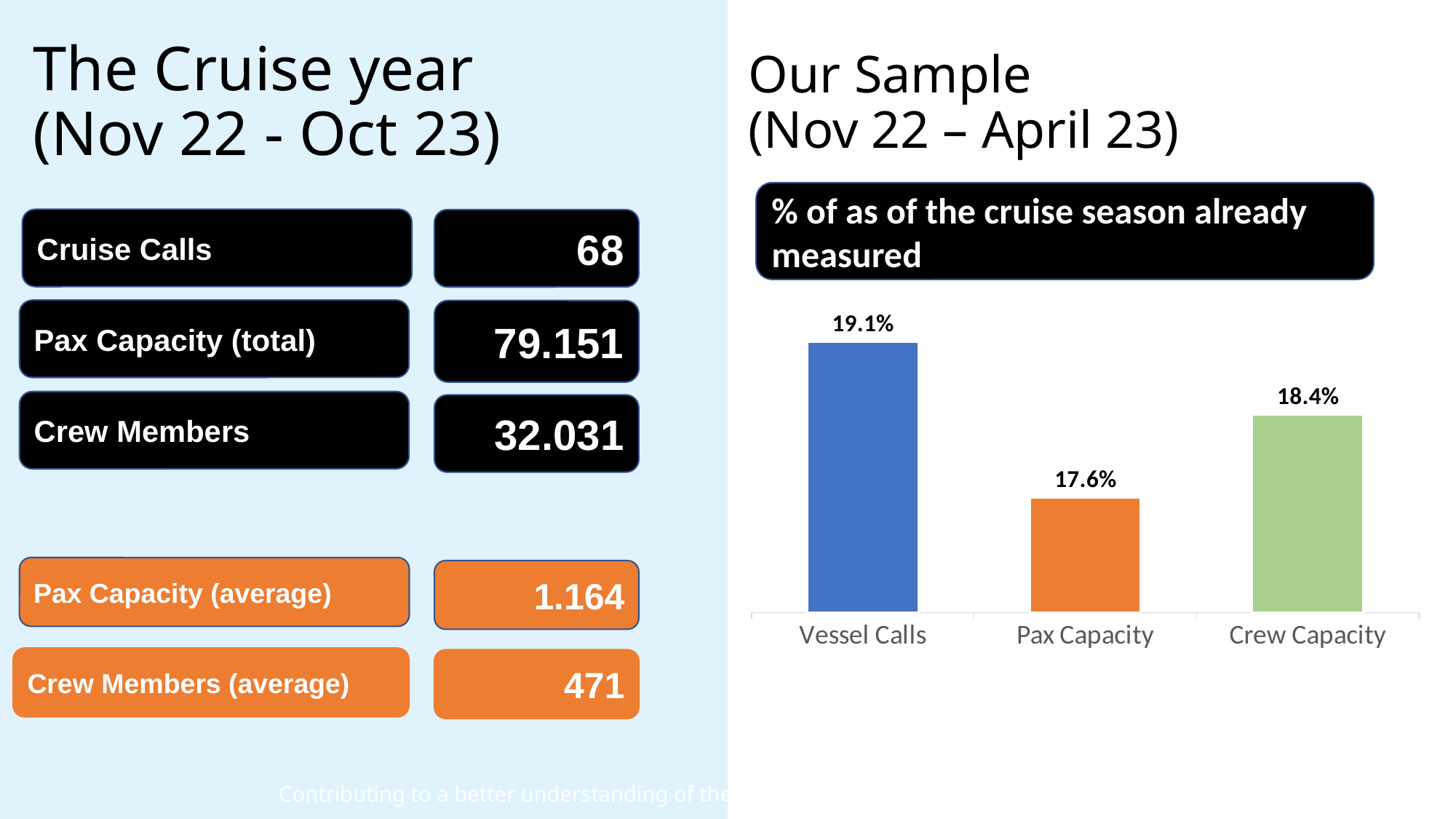
Which category has the highest value in the chart? Vessel Calls How many categories are shown in the chart? 3 What is the difference between the values for Vessel Calls and Pax Capacity? 1.5% Which is larger, the value for Vessel Calls or the value for Crew Capacity? Vessel Calls Which category has the lowest value in the chart? Pax Capacity What colour is the bar for Pax Capacity? orange What is the difference between the values for Crew Capacity and Pax Capacity? 0.8% What kind of chart is shown on the slide? bar chart What is the title of the chart? % of as of the cruise season already measured What is the value for Pax Capacity in the chart? 17.6% What is the value for Crew Capacity in the chart? 18.4% What is the value for Vessel Calls in the chart? 19.1%